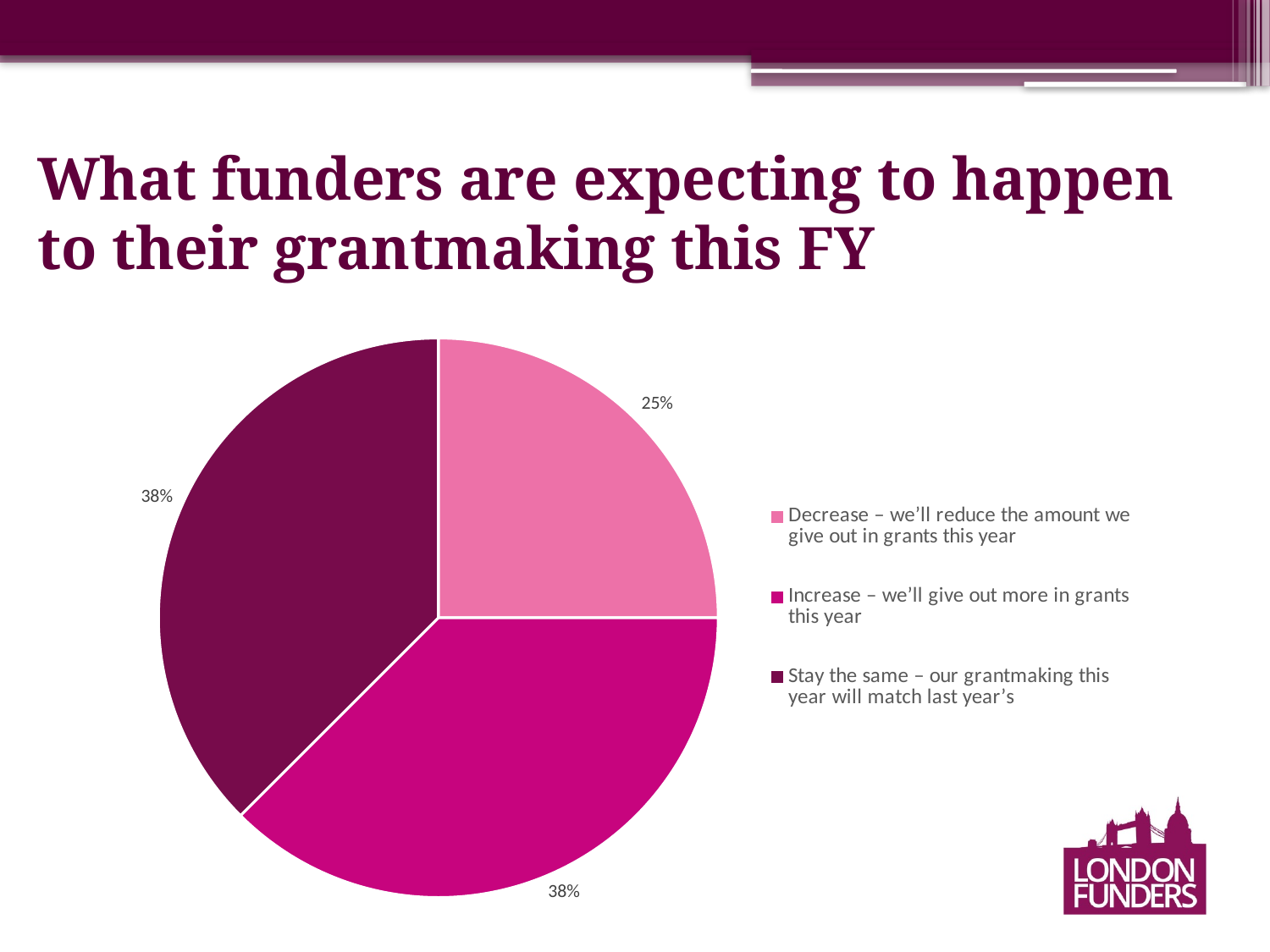
Which is larger: the share of funders expecting to increase grants or the share expecting to decrease grants? Increase How many entries does the legend list? 3 How many slices does the pie chart have? 3 What is the difference in percentage points between the 'Increase' slice and the 'Decrease' slice? 13 percentage points What share of the pie does the 'Decrease' slice represent? 25% Which category has the smallest share of the pie? Decrease – we'll reduce the amount we give out in grants this year What kind of chart is shown on the slide? pie chart What percentage of funders expect their grantmaking to stay the same this year? 38% What percentage of funders expect to increase the amount they give out in grants this year? 38% What percentage of funders expect to decrease the amount they give out in grants this year? 25% Which legend entry is shown in the lightest pink colour? Decrease – we'll reduce the amount we give out in grants this year Is the share of funders expecting to decrease grants greater or less than 30%? less